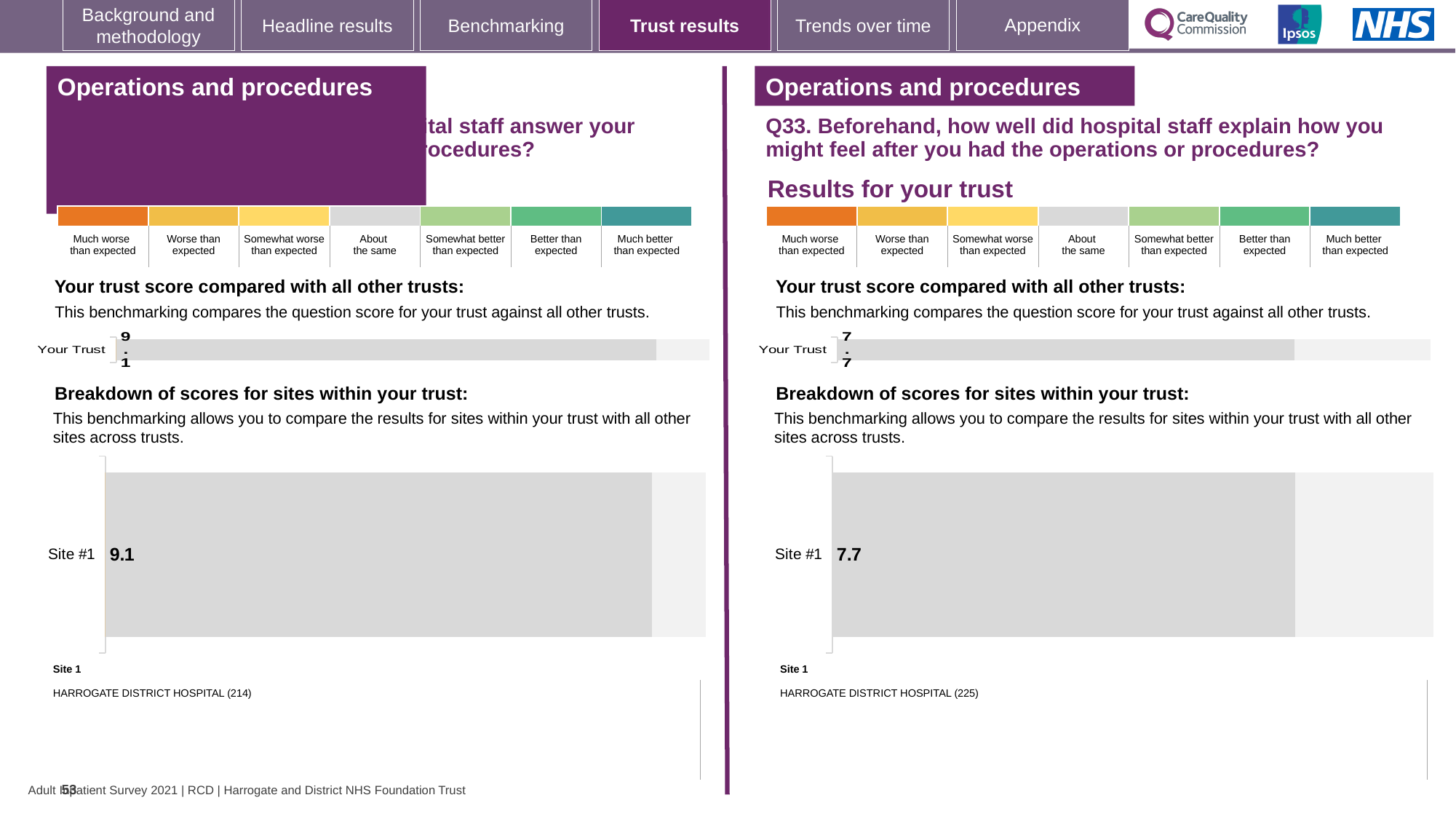
What is the difference between the Site #1 score on the left-hand panel and the Site #1 score on the right-hand panel (Q33)? 1.4 How many sites are shown in the 'Breakdown of scores for sites within your trust' chart on the left-hand panel? 1 On the left-hand panel, what is the score shown for Your Trust in the 'Your trust score compared with all other trusts' chart? 9.1 On the right-hand panel (Q33), is the Your Trust score the same as the Site #1 score? Yes, both are 7.7 On the right-hand panel (Q33), which site name is listed under 'Site 1' below the chart? HARROGATE DISTRICT HOSPITAL (225) Which is larger: the Your Trust score on the left-hand panel or the Your Trust score on the right-hand panel (Q33)? Left-hand panel (9.1) On the left-hand panel, which site name is listed under 'Site 1' below the chart? HARROGATE DISTRICT HOSPITAL (214) On the right-hand panel (Q33), what is the score shown for Your Trust in the 'Your trust score compared with all other trusts' chart? 7.7 On the left-hand panel, what score is shown for Site #1 in the 'Breakdown of scores for sites within your trust' chart? 9.1 What kind of chart is used to show the Site #1 score on the right-hand panel (Q33)? Bar chart On the right-hand panel (Q33), what score is shown for Site #1 in the 'Breakdown of scores for sites within your trust' chart? 7.7 How many sites are shown in the 'Breakdown of scores for sites within your trust' chart on the right-hand panel (Q33)? 1